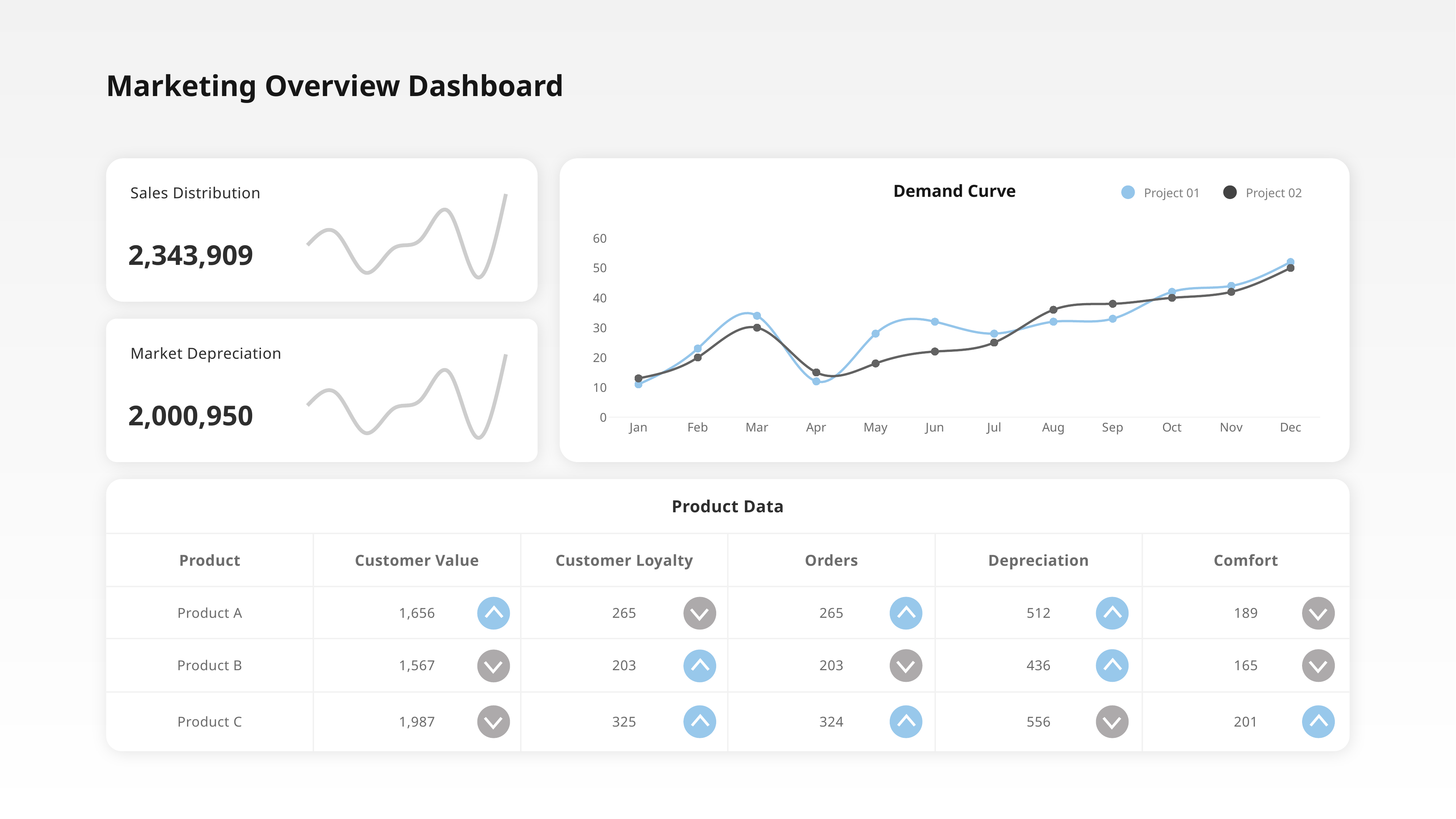
In the Demand Curve chart, which month has the highest value for Project 02? Dec What kind of chart is the Demand Curve chart? line chart In the Demand Curve chart, is the value for Project 01 in Mar greater or less than 30? greater In the Demand Curve chart, does the Project 02 line rise or fall from Aug to Dec? rise In the Demand Curve chart, is the value for Project 02 in May greater or less than 20? less What are the two legend entries of the Demand Curve chart? Project 01 and Project 02 In the Demand Curve chart, which month has the highest value for Project 01? Dec In the Demand Curve chart, is the value for Project 01 in Apr greater or less than 20? less How many months are plotted along the x axis of the Demand Curve chart? 12 In the Demand Curve chart, which series has the larger value in May, Project 01 or Project 02? Project 01 How many series does the legend of the Demand Curve chart list? 2